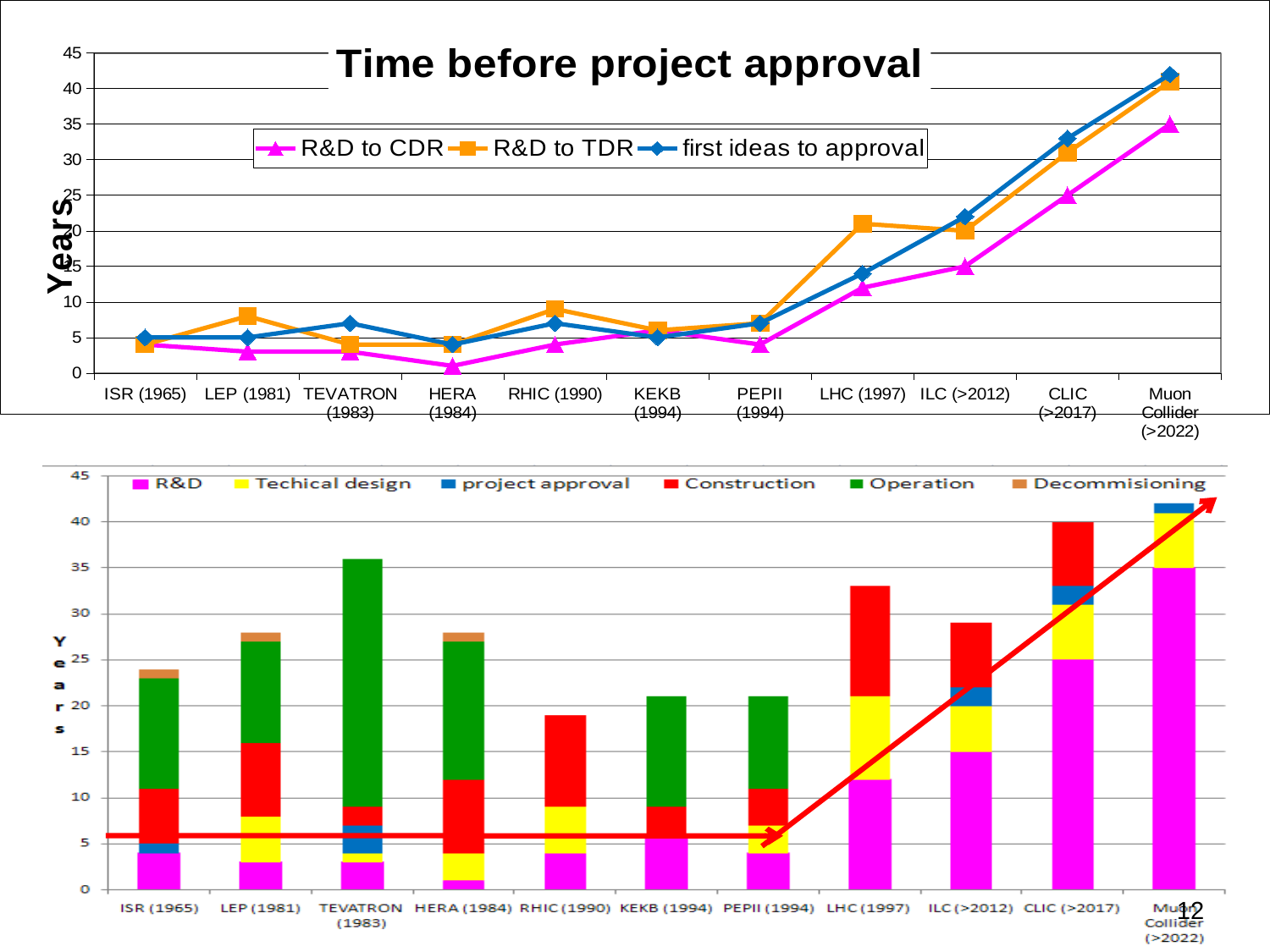
In the bottom chart, which colour represents the 'Construction' series? red In the top chart 'Time before project approval', for LHC (1997), which is larger: 'R&D to TDR' or 'R&D to CDR'? R&D to TDR In the bottom chart, is the total height of the LHC (1997) bar greater or less than 30? greater In the top chart 'Time before project approval', how many series does the legend list? 3 In the top chart 'Time before project approval', how many projects are shown on the x axis? 11 In the top chart 'Time before project approval', is the 'first ideas to approval' value for CLIC (>2017) greater or less than 30? greater What type of chart is the top chart titled 'Time before project approval'? line chart In the top chart 'Time before project approval', which project has the lowest value for 'R&D to CDR'? HERA (1984) What type of chart is the bottom chart on the slide? stacked bar chart In the bottom chart, how many series does the legend list? 6 In the top chart 'Time before project approval', which project has the highest value for 'first ideas to approval'? Muon Collider (>2022) In the bottom chart, which project has the tallest stacked bar? Muon Collider (>2022)